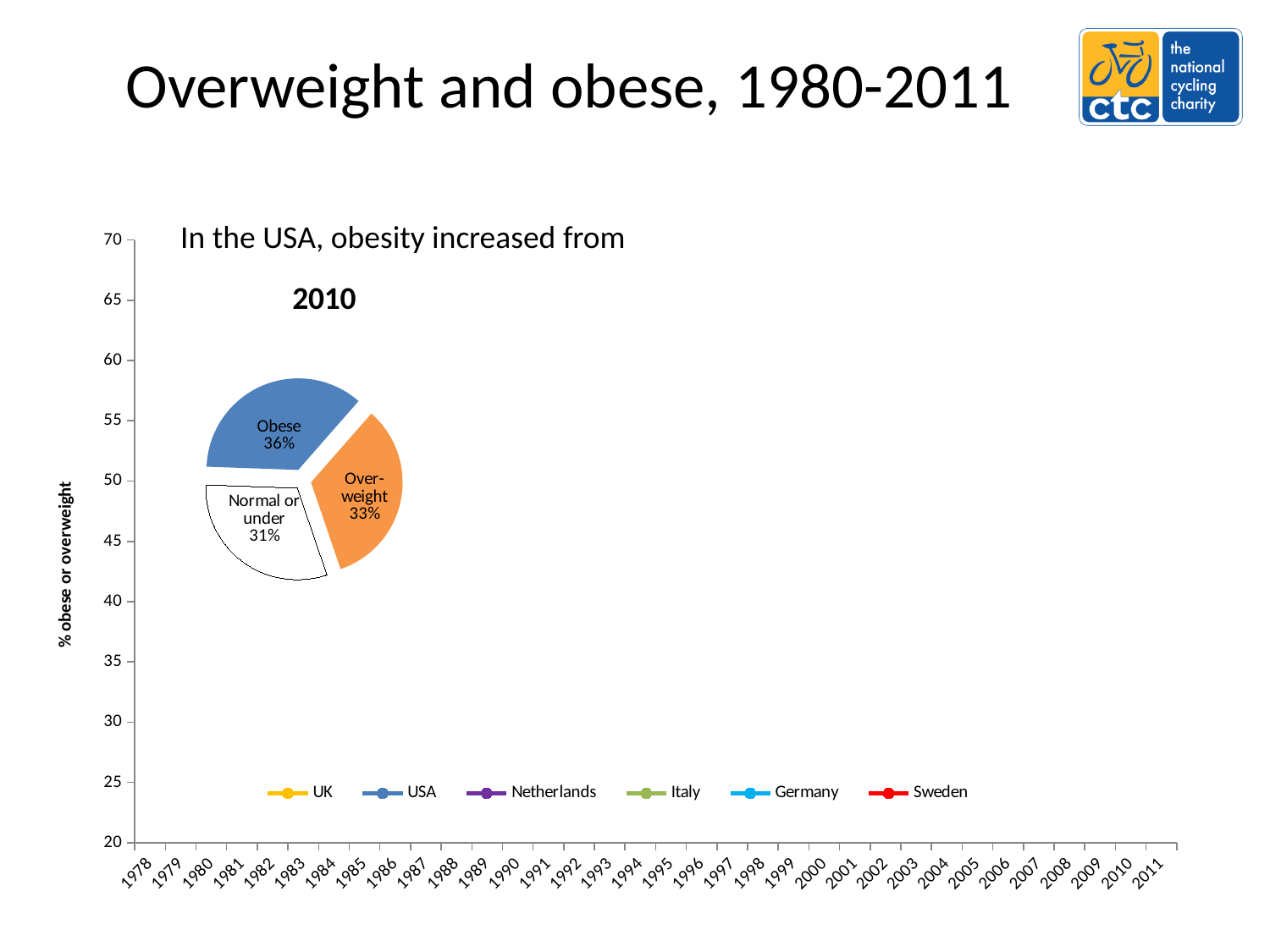
In the pie chart titled 2010, what is the difference in percentage points between the Obese slice and the Normal or under slice? 5 How many series does the legend of the large chart at the bottom of the slide list? 6 In the pie chart titled 2010, which slice is the largest? Obese In the pie chart titled 2010, what percentage is labelled Overweight? 33% In the pie chart titled 2010, which slice is the smallest? Normal or under What is the y-axis label of the large chart at the bottom of the slide? % obese or overweight In the pie chart titled 2010, which is larger, the Obese slice or the Overweight slice? Obese In the pie chart titled 2010, what percentage is labelled Normal or under? 31% In the pie chart titled 2010, what percentage is labelled Obese? 36% In the legend of the large chart at the bottom of the slide, which country is shown in red? Sweden What kind of chart is the chart titled 2010? pie chart How many slices does the pie chart titled 2010 have? 3